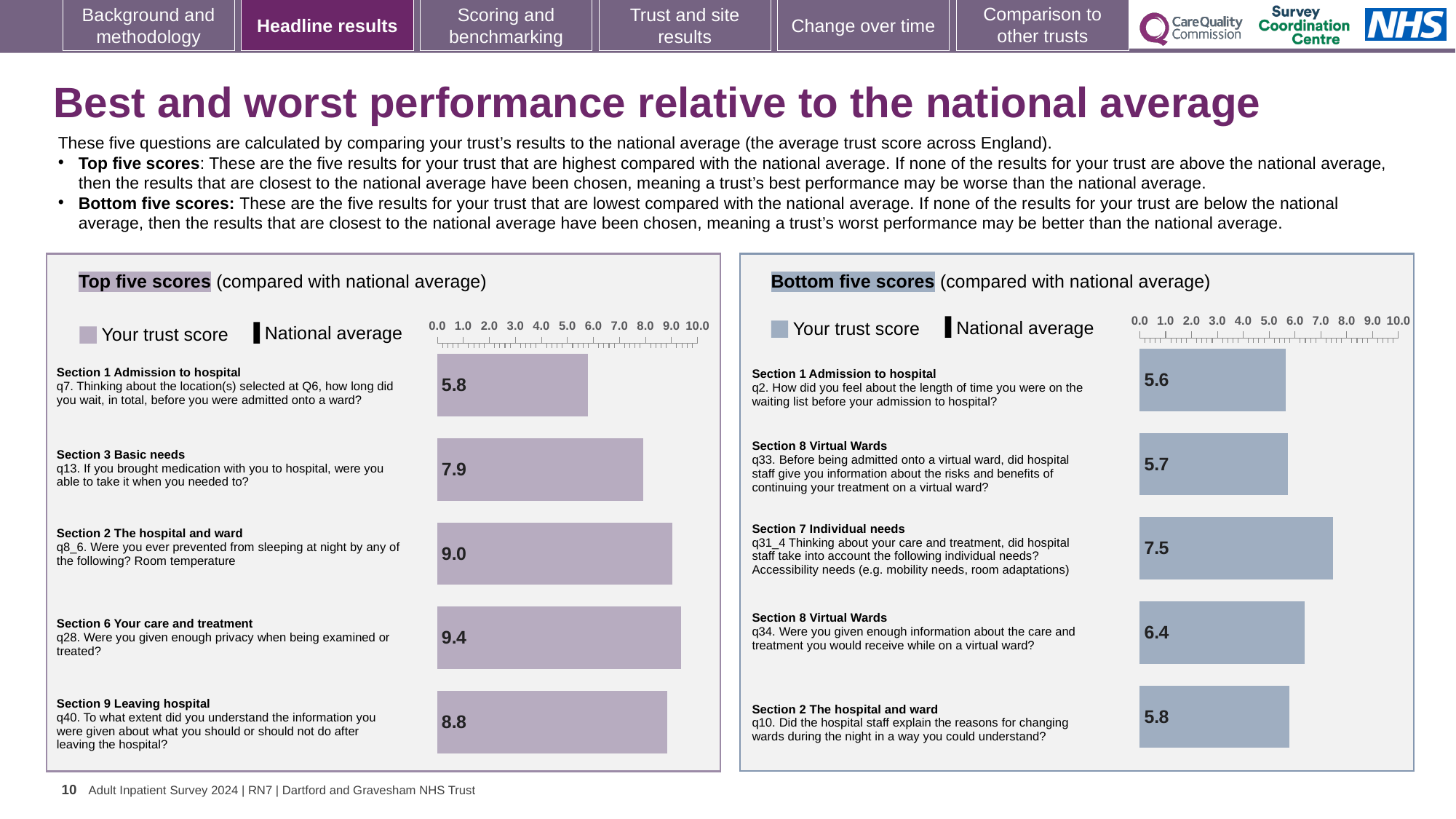
What type of chart is used for the Top five scores? Bar chart In the Top five scores chart, what is the difference between the trust scores for q28 and q7? 3.6 In the Top five scores chart, what is the trust score for q13 (Section 3 Basic needs)? 7.9 In the Bottom five scores chart, what is the difference between the trust scores for q31_4 and q2? 1.9 In the Top five scores chart, is the trust score for q40 greater or less than 8.0? greater In the Bottom five scores chart, which question has the highest trust score? q31_4 (Section 7 Individual needs), 7.5 How many bars are plotted in the Top five scores chart? 5 In the Bottom five scores chart, what is the trust score for q34 (Section 8 Virtual Wards)? 6.4 In the Top five scores chart, which question has the highest trust score? q28 (Section 6 Your care and treatment), 9.4 In the Bottom five scores chart, which question has the lowest trust score? q2 (Section 1 Admission to hospital), 5.6 In the Bottom five scores chart, which has the larger trust score: q31_4 or q34? q31_4 How many series does the legend of the Bottom five scores chart list? 2